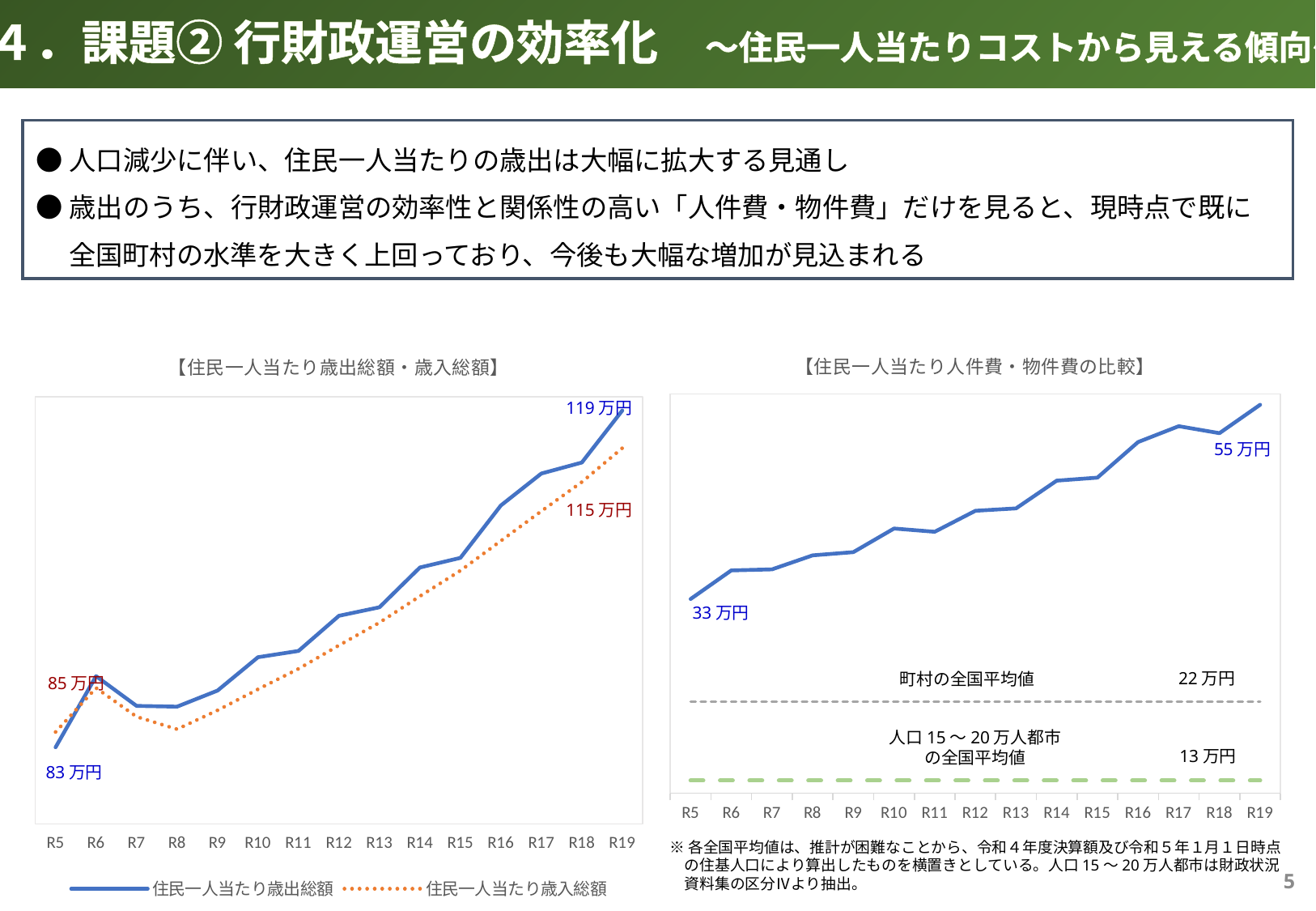
In the left chart 【住民一人当たり歳出総額・歳入総額】, what is the value of 住民一人当たり歳入総額 at R5? 85万円 In the left chart 【住民一人当たり歳出総額・歳入総額】, what is the difference between 住民一人当たり歳出総額 and 住民一人当たり歳入総額 at R19? 4万円 In the right chart 【住民一人当たり人件費・物件費の比較】, what is the 町村の全国平均値? 22万円 How many series does the legend of the left chart 【住民一人当たり歳出総額・歳入総額】 list? 2 What kind of chart is the left chart titled 【住民一人当たり歳出総額・歳入総額】? line chart In the right chart 【住民一人当たり人件費・物件費の比較】, what is the difference between the R19 value of the blue line and the 町村の全国平均値? 33万円 In the right chart 【住民一人当たり人件費・物件費の比較】, what is the value of the blue line at R19? 55万円 In the left chart 【住民一人当たり歳出総額・歳入総額】, what is the value of 住民一人当たり歳入総額 at R19? 115万円 In the left chart 【住民一人当たり歳出総額・歳入総額】, what is the value of 住民一人当たり歳出総額 at R5? 83万円 In the left chart 【住民一人当たり歳出総額・歳入総額】, what is the value of 住民一人当たり歳出総額 at R19? 119万円 How many years are shown on the x axis of the left chart 【住民一人当たり歳出総額・歳入総額】? 15 In the left chart 【住民一人当たり歳出総額・歳入総額】, does 住民一人当たり歳出総額 rise or fall overall from R5 to R19? rise